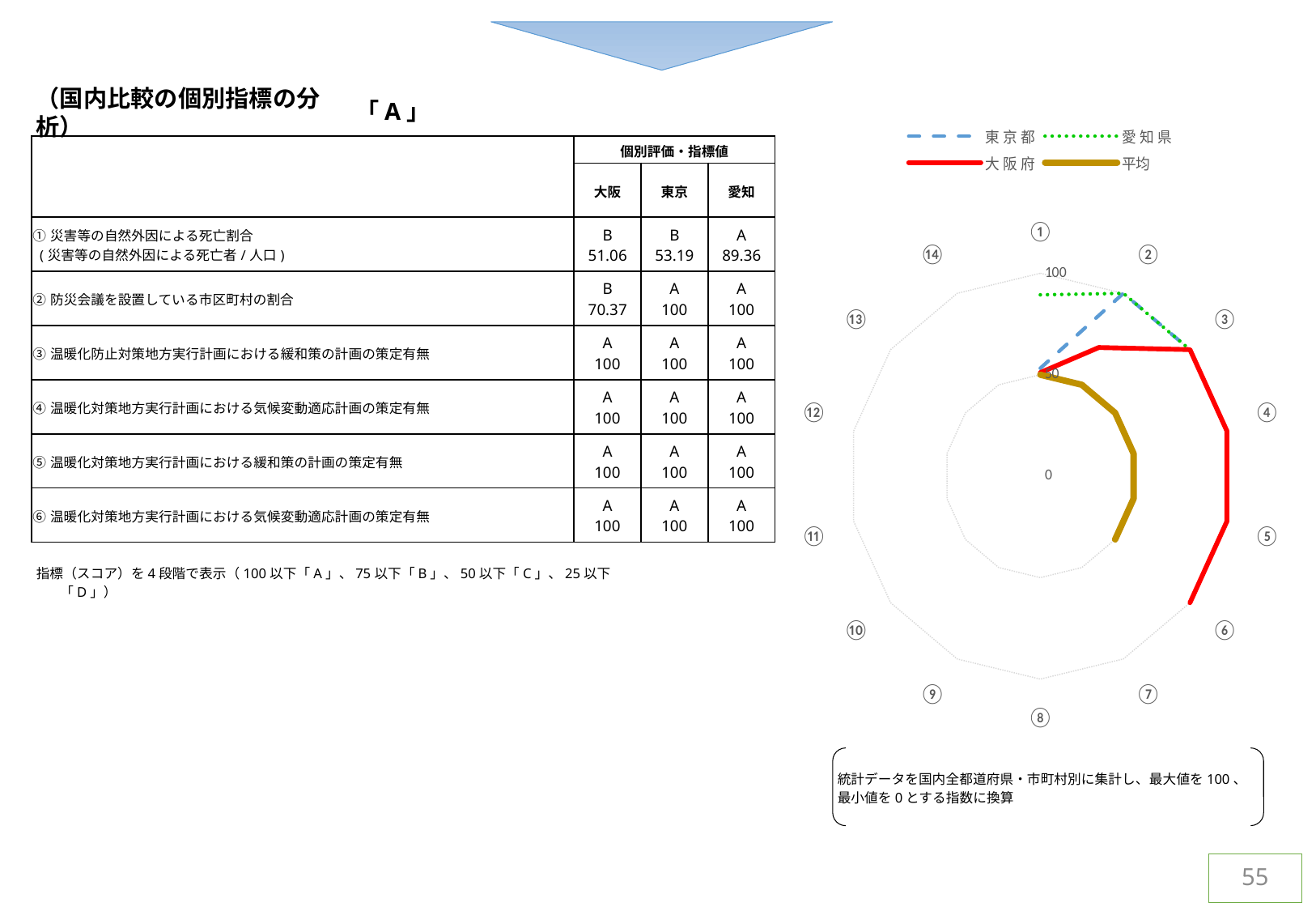
Which series in the radar chart is drawn as a green dotted line? 愛知県 How many numbered axes (categories) does the radar chart have? 14 Which series in the radar chart is drawn as a solid red line? 大阪府 How many series does the legend of the radar chart list? 4 In the radar chart, is the value for 愛知県 at axis ① greater or less than 50? greater In the radar chart, is the value for 大阪府 at axis ④ greater or less than 50? greater In the radar chart, which is larger at axis ①: the value for 愛知県 or the value for 大阪府? 愛知県 According to the table on the slide, what is the difference between the 愛知 value and the 大阪 value for indicator ①? 38.30 According to the table on the slide, what is the 大阪 value for indicator ② (防災会議を設置している市区町村の割合)? 70.37 In the radar chart, which is larger at axis ④: the value for 大阪府 or the value for 平均? 大阪府 In the radar chart, is the value for 東京都 at axis ② greater or less than 50? greater What kind of chart is shown on the right side of the slide? radar chart